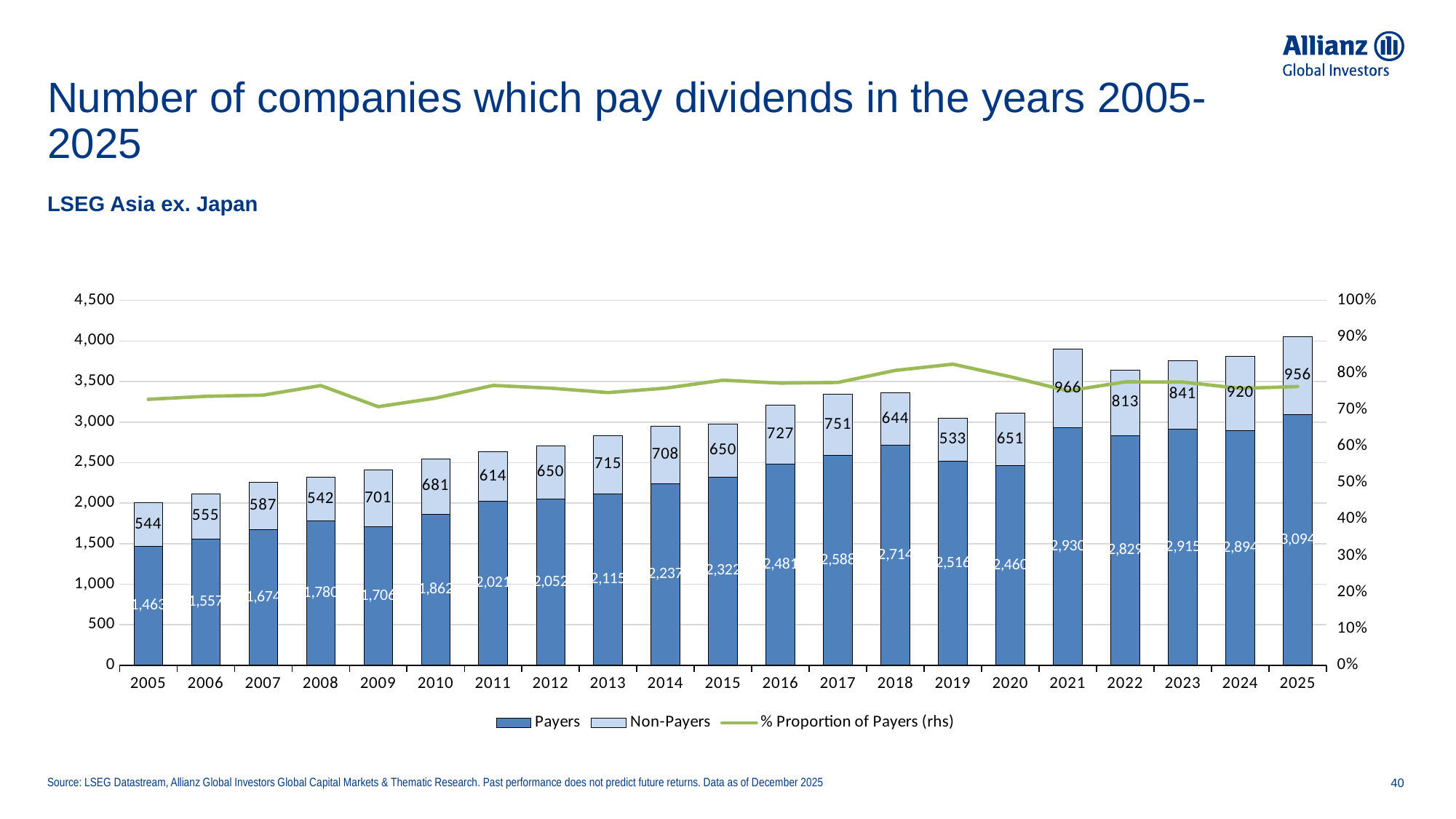
Which is larger, the Payers value for 2021 or for 2022? 2021 Which year has the lowest number of Payers? 2005 How many years are shown on the x axis? 21 How many companies were Payers in 2025? 3,094 Which year has the highest number of Payers? 2025 How many series does the legend list? 3 Which year has the lowest Non-Payers value? 2019 What is the Payers value for 2009? 1,706 What is the Non-Payers value for 2021? 966 Is the % Proportion of Payers line for 2005 greater or less than 80%? less What is the total height of the stacked bar for 2025 (Payers plus Non-Payers)? 4,050 What is the difference between the Payers values for 2025 and 2024? 200